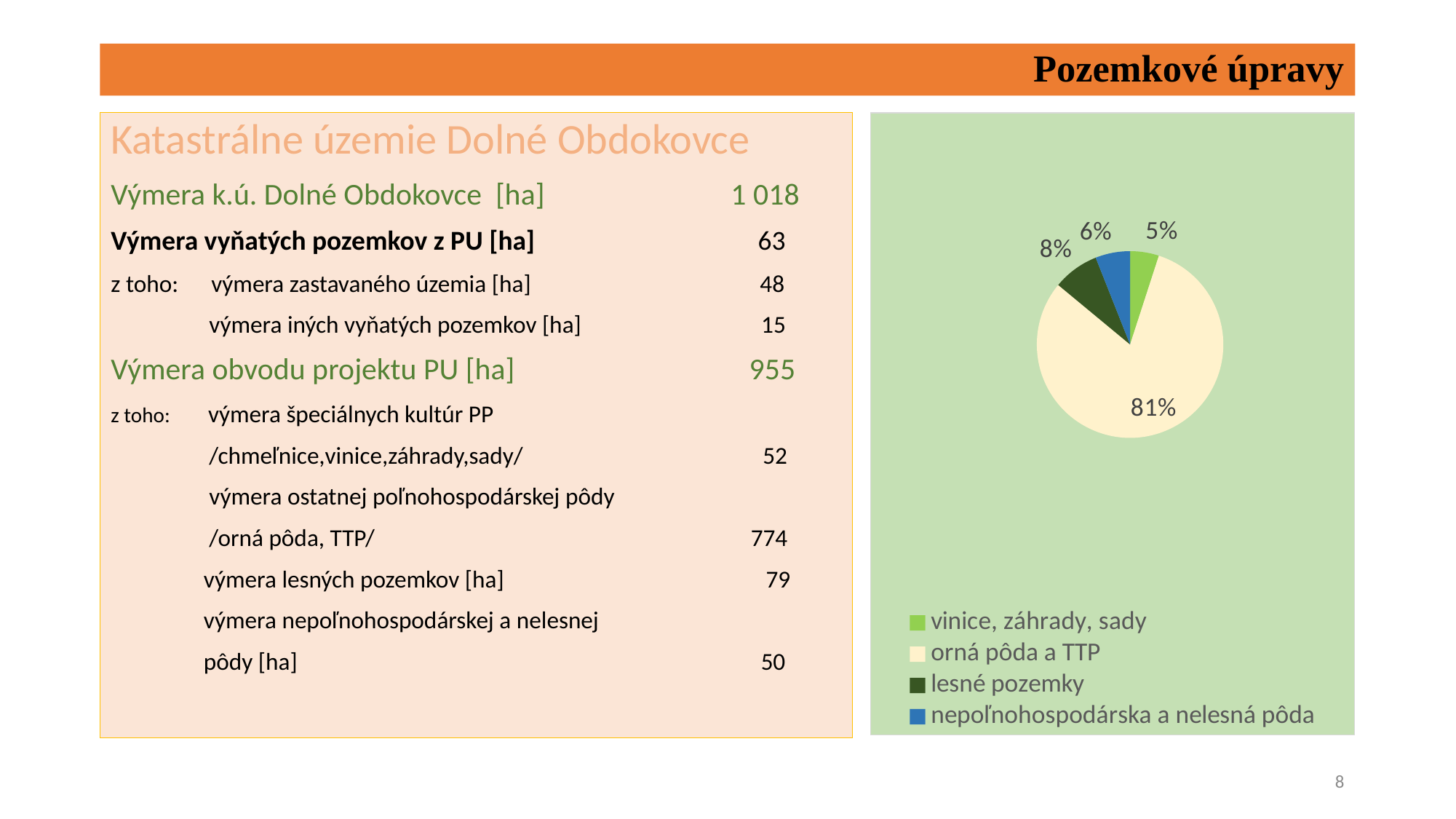
How many categories does the pie chart show? 4 Which is larger, the share for "lesné pozemky" or the share for "nepoľnohospodárska a nelesná pôda"? lesné pozemky Which category has the largest slice of the pie? orná pôda a TTP What share of the pie does "vinice, záhrady, sady" represent? 5% What share of the pie does "nepoľnohospodárska a nelesná pôda" represent? 6% What is the difference in percentage points between "orná pôda a TTP" and "lesné pozemky"? 73 Which legend entry is shown in dark green? lesné pozemky What kind of chart is shown on the slide? pie chart What share of the pie does "lesné pozemky" represent? 8% What colour is the slice for "nepoľnohospodárska a nelesná pôda"? blue Which category has the smallest slice of the pie? vinice, záhrady, sady